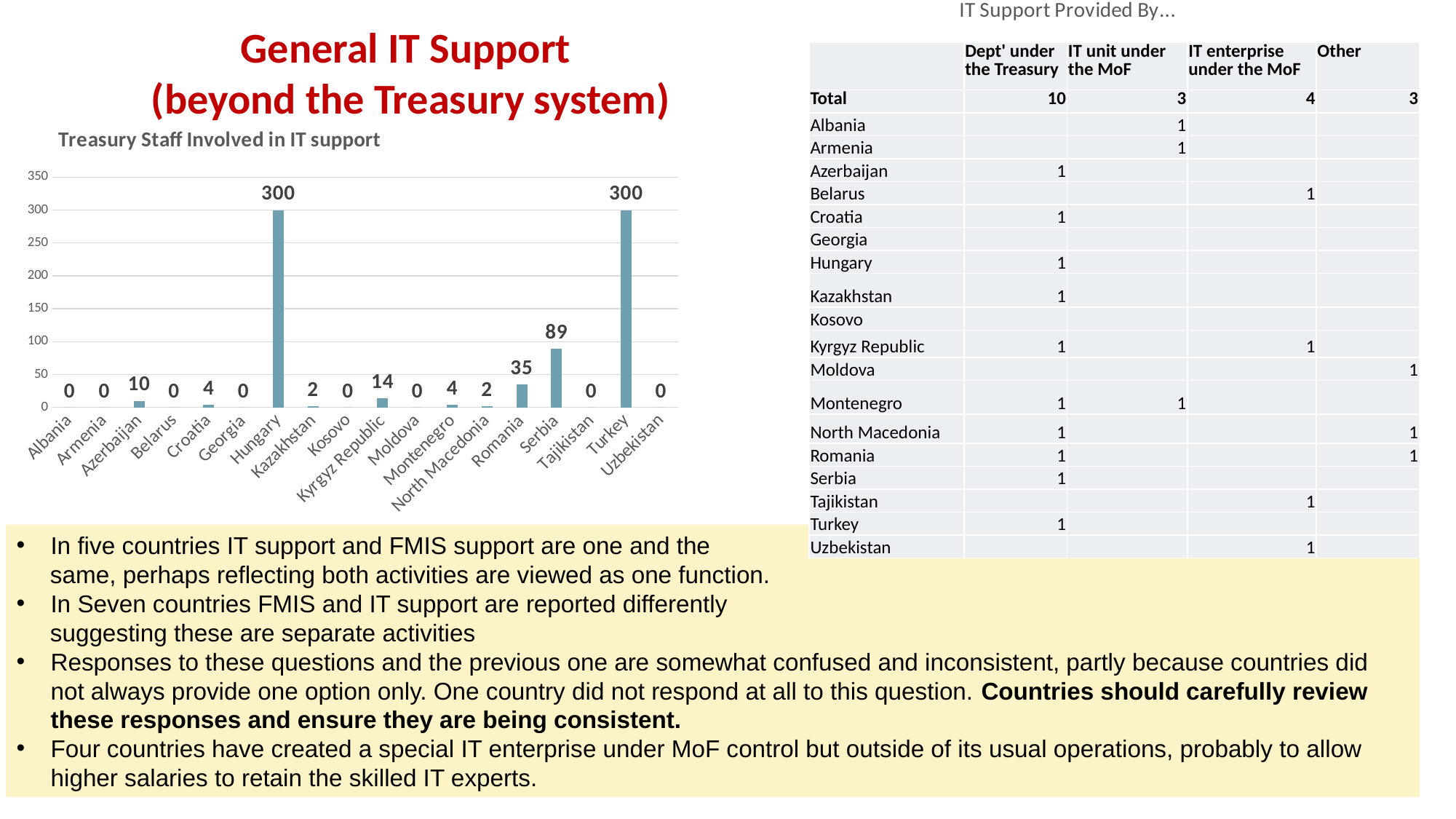
What is the value for Croatia in the Treasury Staff Involved in IT support chart? 4 What is the difference between the values for Turkey and Serbia in the Treasury Staff Involved in IT support chart? 211 How many countries are shown on the x axis of the Treasury Staff Involved in IT support chart? 18 What is the value for Serbia in the Treasury Staff Involved in IT support chart? 89 Is the value for Serbia in the Treasury Staff Involved in IT support chart greater or less than 50? greater What is the value for Romania in the Treasury Staff Involved in IT support chart? 35 What is the value for Azerbaijan in the Treasury Staff Involved in IT support chart? 10 What is the difference between the values for Serbia and Romania in the Treasury Staff Involved in IT support chart? 54 What is the value for Kyrgyz Republic in the Treasury Staff Involved in IT support chart? 14 What kind of chart is the Treasury Staff Involved in IT support chart? bar chart Which has a larger value in the Treasury Staff Involved in IT support chart, Serbia or Romania? Serbia What is the value for Hungary in the Treasury Staff Involved in IT support chart? 300